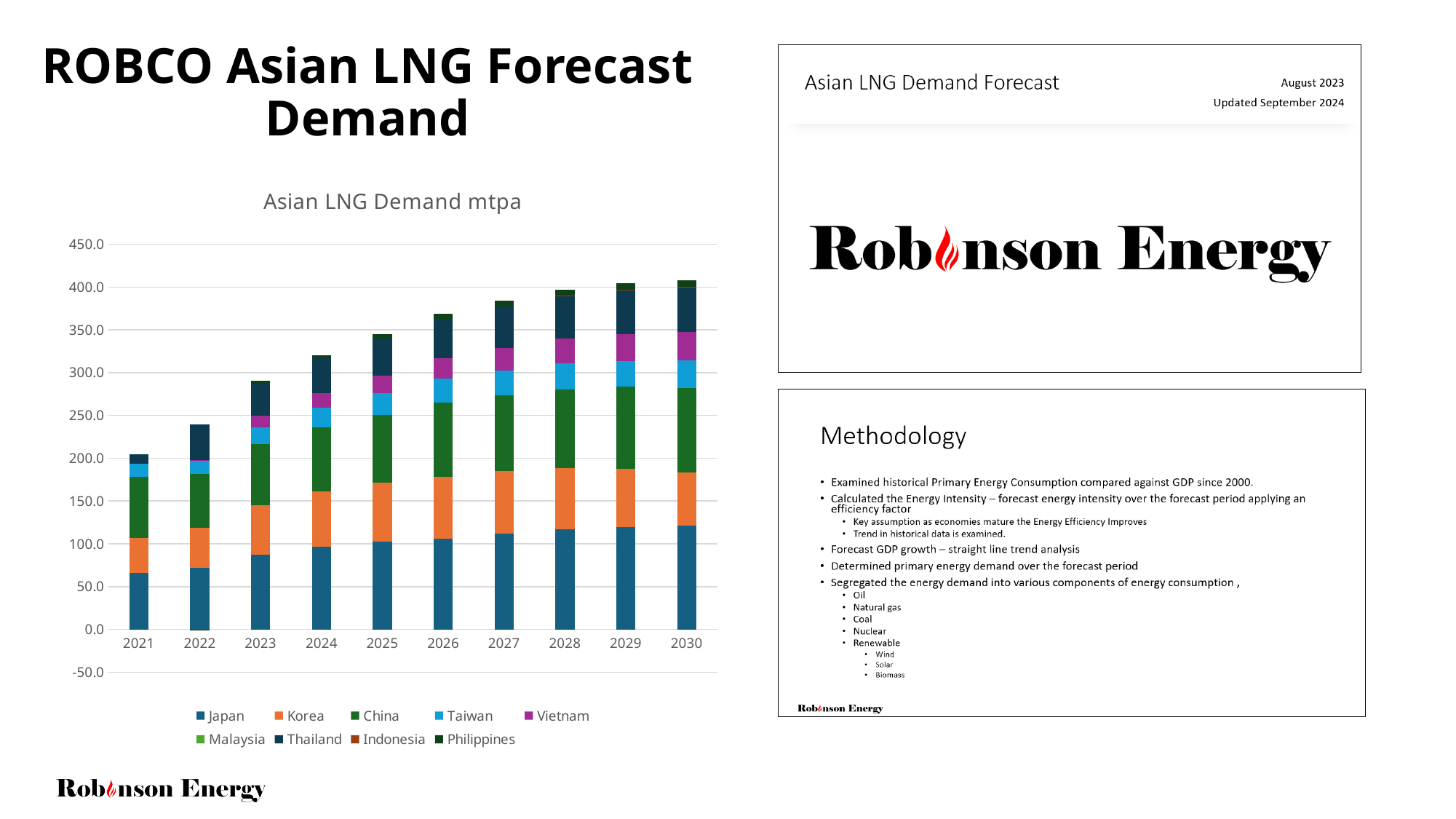
Is the value for Japan in 2021 greater or less than 50? greater How many years are shown on the x axis of the chart? 10 Which year has the larger total stacked value, 2022 or 2025? 2025 Which series is shown in orange in the chart's legend? Korea Is the total stacked value for 2021 greater or less than 250? less Is the total stacked value for 2024 greater or less than 300? greater Do the total stacked values rise or fall from 2021 to 2030? Rise What is the title of the chart? Asian LNG Demand mtpa What kind of chart is shown on the slide? Stacked bar chart How many series does the chart's legend list? 9 Which year has the lowest total stacked value? 2021